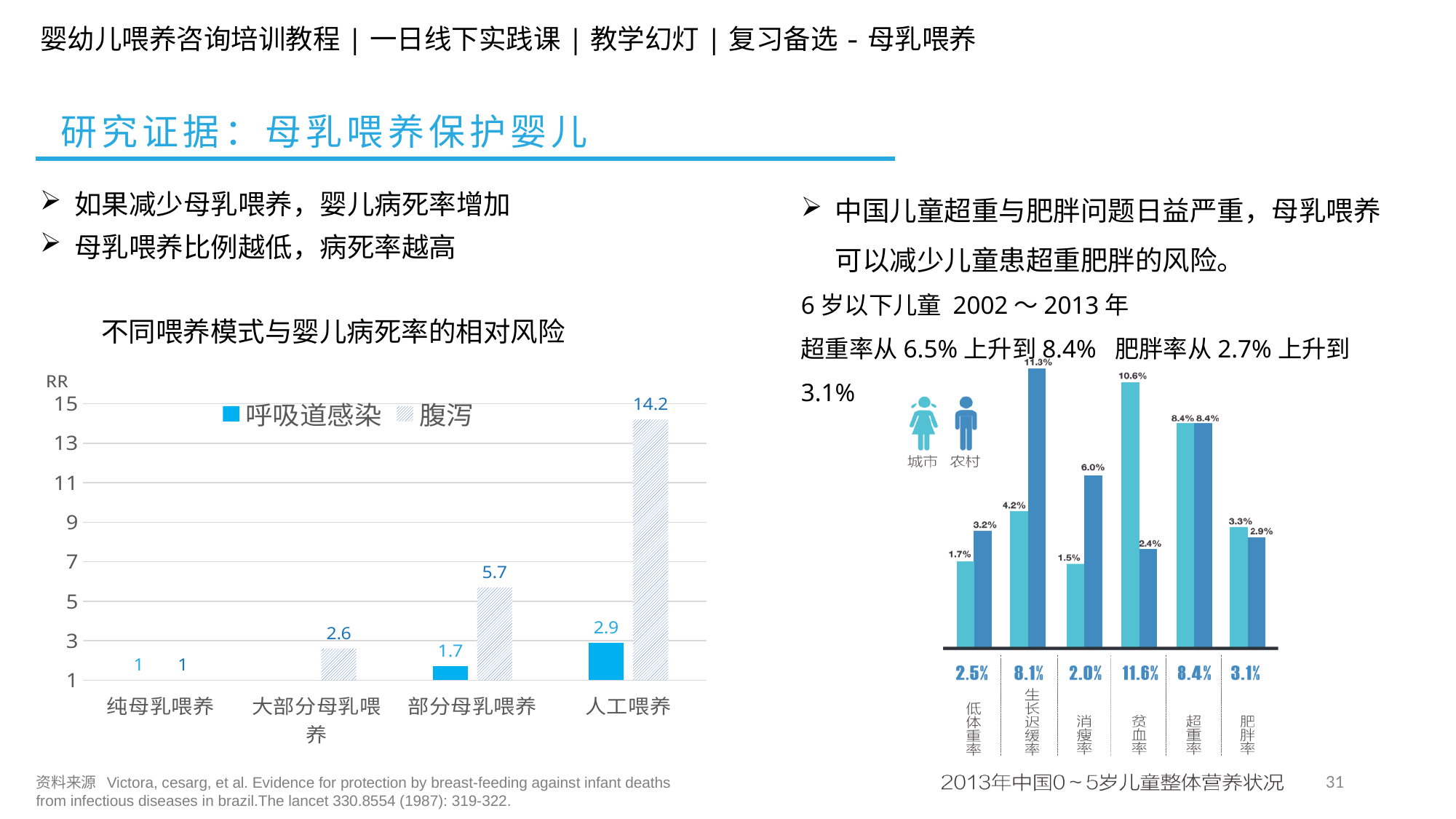
In the chart titled 2013年中国0～5岁儿童整体营养状况, what is the difference between the 农村 and 城市 values for 低体重率? 1.5% In the chart titled 不同喂养模式与婴儿病死率的相对风险, what is the difference between the 腹泻 values for 人工喂养 and 部分母乳喂养? 8.5 In the chart titled 不同喂养模式与婴儿病死率的相对风险, which feeding category has the highest 腹泻 value? 人工喂养 In the chart titled 2013年中国0～5岁儿童整体营养状况, what is the 城市 value for 贫血率? 10.6% In the chart titled 不同喂养模式与婴儿病死率的相对风险, what is the 腹泻 value for 人工喂养? 14.2 In the chart titled 不同喂养模式与婴儿病死率的相对风险, what kind of chart is shown? bar chart In the chart titled 2013年中国0～5岁儿童整体营养状况, what is the 农村 value for 生长迟缓率? 11.3% In the chart titled 不同喂养模式与婴儿病死率的相对风险, what is the 呼吸道感染 value for 部分母乳喂养? 1.7 In the chart titled 2013年中国0～5岁儿童整体营养状况, how many indicator categories are shown on the x axis? 6 In the chart titled 不同喂养模式与婴儿病死率的相对风险, do the 腹泻 values rise or fall from 纯母乳喂养 to 人工喂养? rise In the chart titled 不同喂养模式与婴儿病死率的相对风险, how many series does the legend list? 2 In the chart titled 2013年中国0～5岁儿童整体营养状况, which is larger for 消瘦率, the 城市 value or the 农村 value? 农村